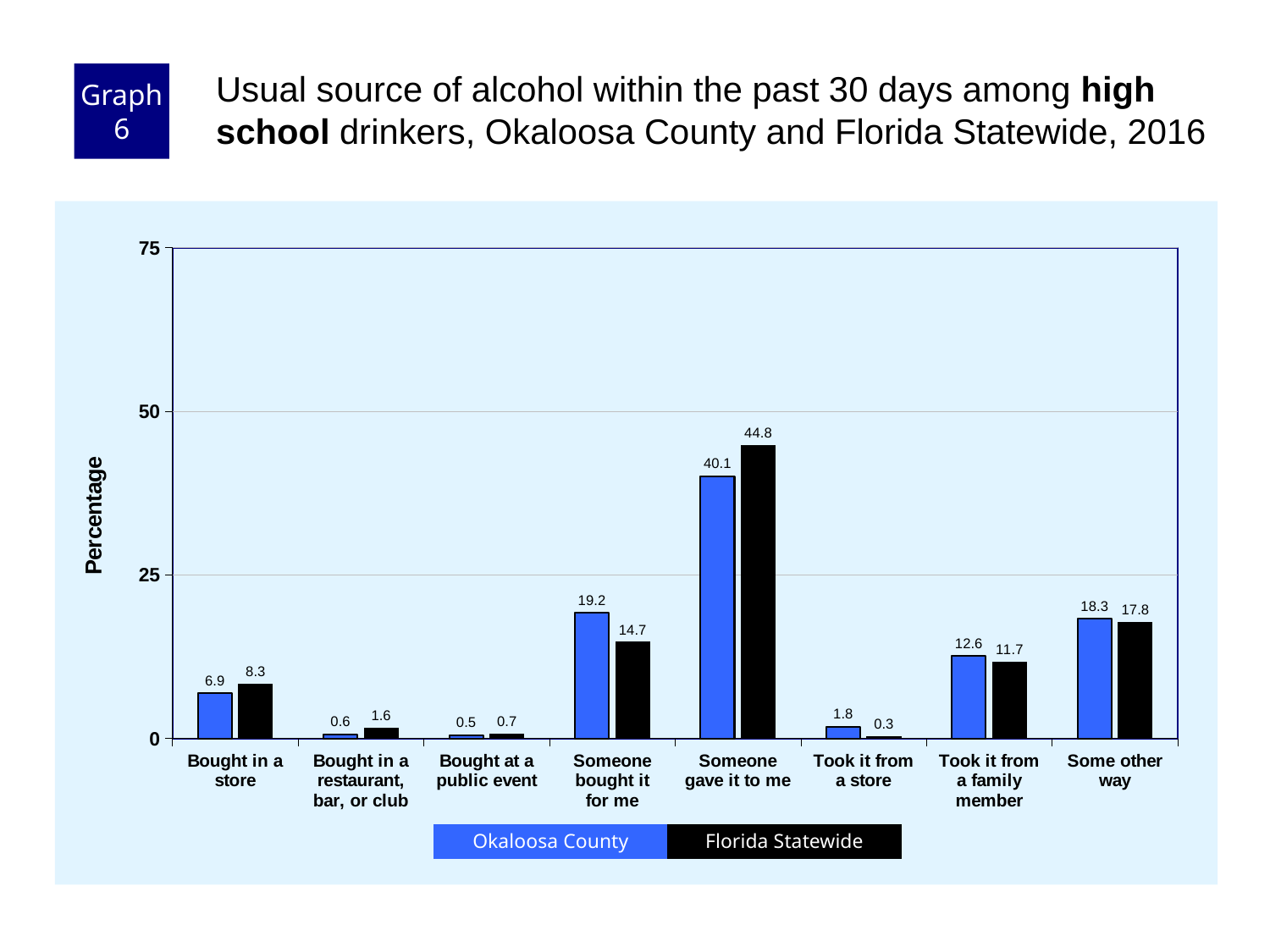
How many categories are shown on the x axis? 8 What is the Okaloosa County value for "Took it from a family member"? 12.6 Is the Florida Statewide value for "Someone gave it to me" greater or less than 50? less Which category has the lowest Okaloosa County value? Bought at a public event How many series does the legend list? 2 Which is larger for "Someone bought it for me": Okaloosa County or Florida Statewide? Okaloosa County Which category has the highest Florida Statewide value? Someone gave it to me What is the difference between the Florida Statewide and Okaloosa County values for "Someone gave it to me"? 4.7 What is the Okaloosa County value for "Someone gave it to me"? 40.1 What is the Florida Statewide value for "Bought in a store"? 8.3 What kind of chart is shown on the slide? bar chart What is the label of the y axis? Percentage